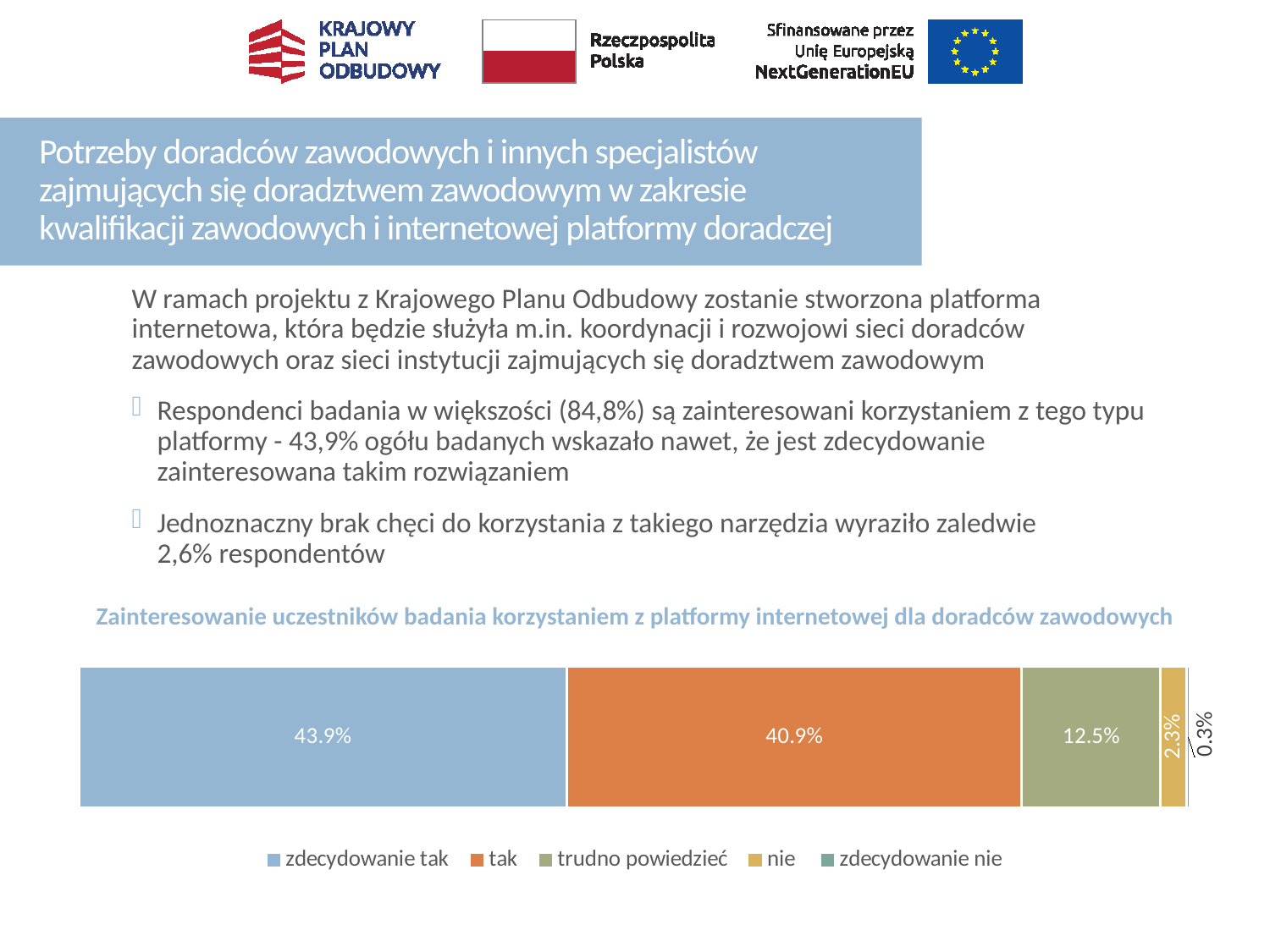
What percentage of respondents answered "zdecydowanie tak" in the chart? 43.9% What is the difference between the "zdecydowanie tak" and "tak" shares? 3.0% How many response categories does the legend list? 5 Which response category has the largest share in the chart? zdecydowanie tak What percentage of respondents answered "tak" in the chart? 40.9% What kind of chart is shown on the slide? Stacked bar chart What percentage of respondents answered "nie"? 2.3% What is the combined share of "zdecydowanie tak" and "tak"? 84.8% What percentage of respondents answered "trudno powiedzieć"? 12.5% Which response category has the smallest share in the chart? zdecydowanie nie What percentage of respondents answered "zdecydowanie nie"? 0.3% Which is larger: the share for "trudno powiedzieć" or the share for "nie"? trudno powiedzieć